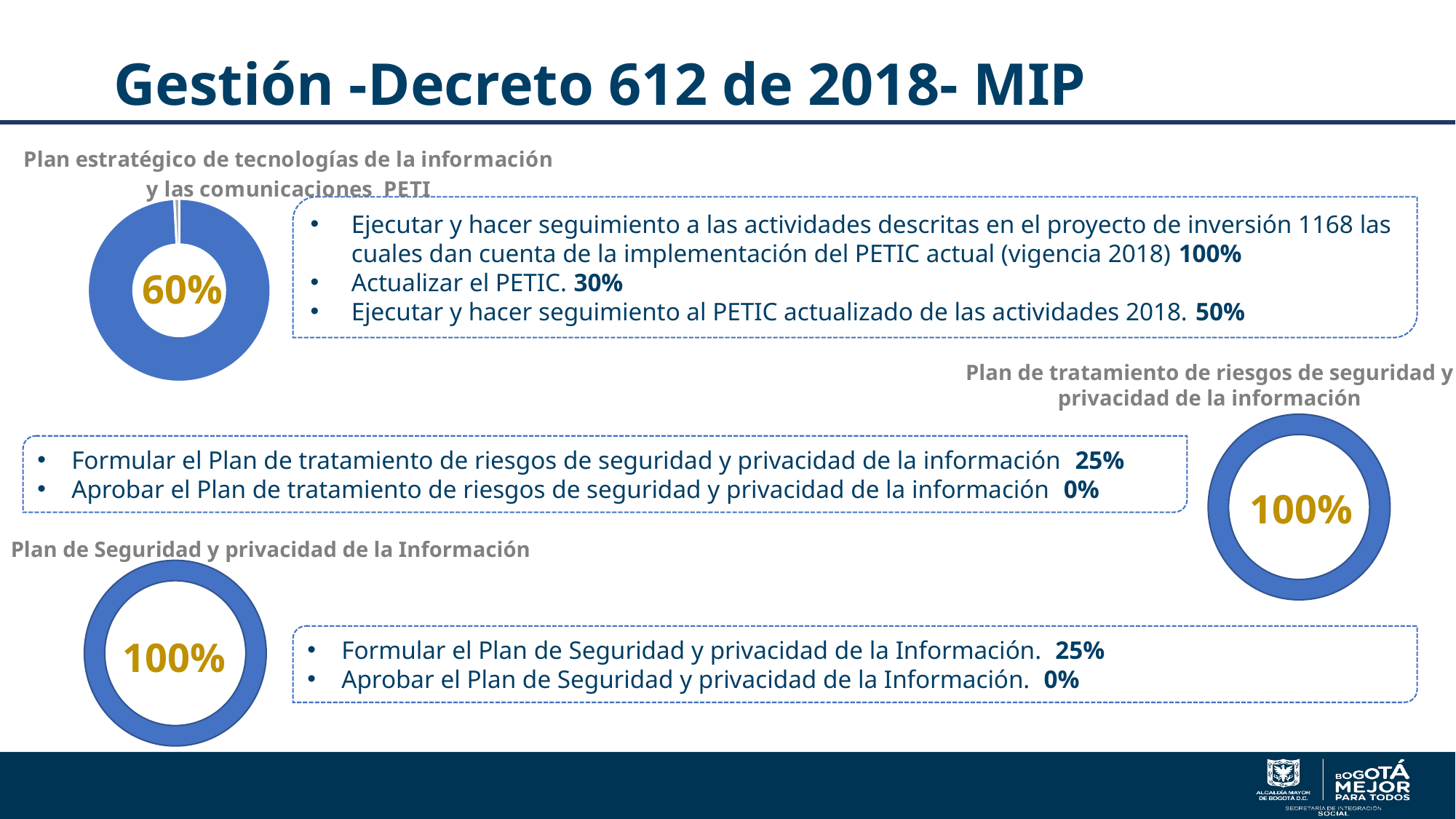
What is the heading above the doughnut chart in the bottom-left of the slide? Plan de Seguridad y privacidad de la Información In the 'Plan de tratamiento de riesgos de seguridad y privacidad de la información' chart, what percentage is shown in the centre? 100% What is the difference between the percentage in the 'Plan de tratamiento de riesgos de seguridad y privacidad de la información' chart and the percentage in the PETI chart? 40% How many doughnut charts are on the slide? 3 What colour is the ring of the doughnut charts on the slide? Blue Which chart shows the lowest percentage: PETI, Plan de tratamiento de riesgos, or Plan de Seguridad y privacidad? PETI In the 'Plan de Seguridad y privacidad de la Información' chart, what percentage is shown in the centre? 100% What kind of chart is shown under the heading 'Plan estratégico de tecnologías de la información y las comunicaciones PETI'? Doughnut chart Is the percentage shown in the PETI chart greater or less than 50%? greater Which is larger, the percentage in the PETI chart or the percentage in the 'Plan de Seguridad y privacidad de la Información' chart? Plan de Seguridad y privacidad de la Información In the 'Plan estratégico de tecnologías de la información y las comunicaciones PETI' chart, what percentage is shown in the centre? 60%